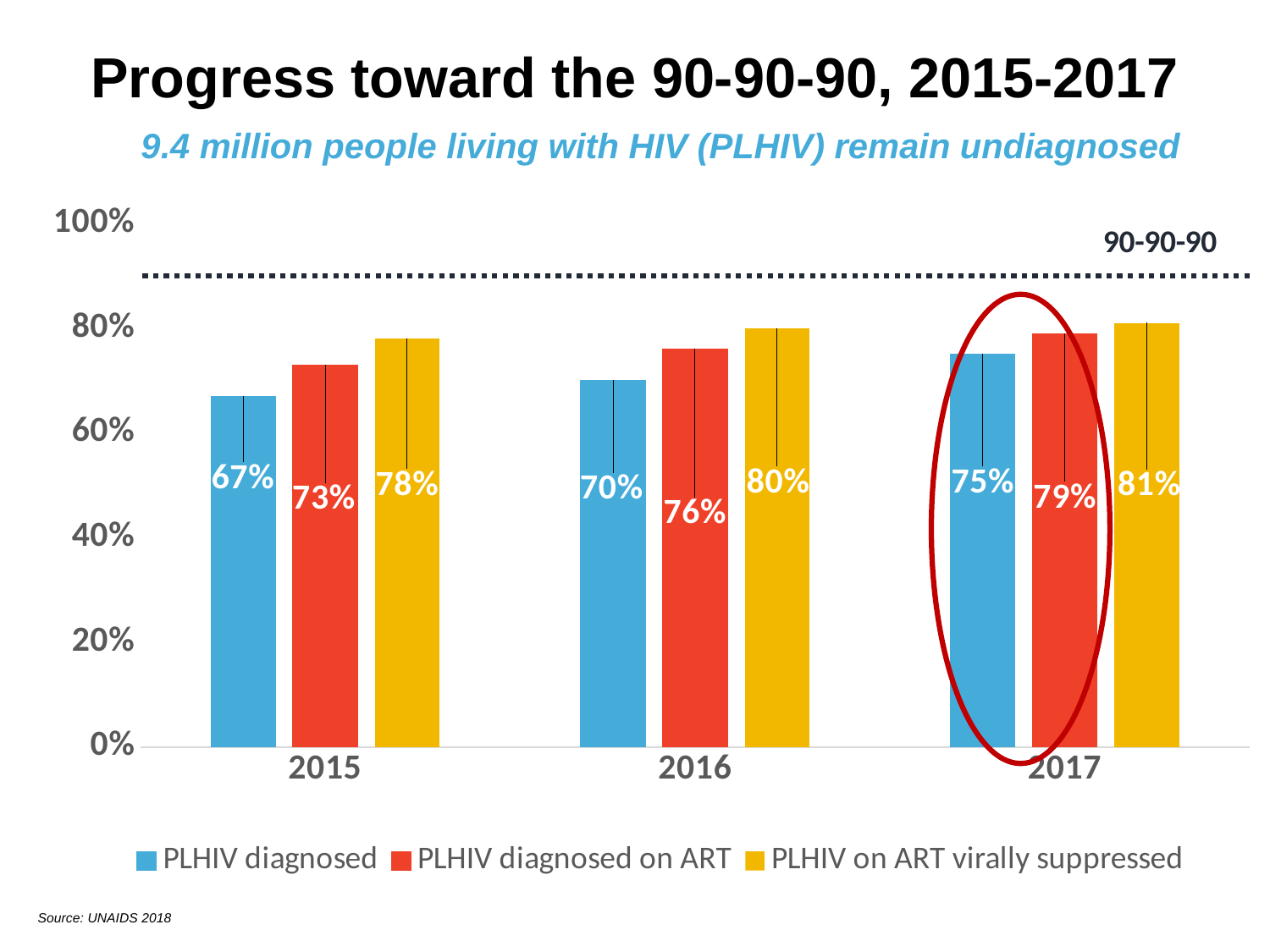
How many series does the legend list? 3 What is the value for PLHIV on ART virally suppressed in 2017? 81% Which is larger: PLHIV on ART virally suppressed in 2016 or PLHIV diagnosed on ART in 2017? PLHIV on ART virally suppressed in 2016 What is the value for PLHIV diagnosed in 2015? 67% Does the value for PLHIV on ART virally suppressed rise or fall from 2015 to 2017? rise What kind of chart is shown on the slide? bar chart What is the difference between PLHIV diagnosed in 2017 and PLHIV diagnosed in 2015? 8% How many years are shown on the x axis? 3 What is the value for PLHIV diagnosed on ART in 2016? 76% Is the value for PLHIV diagnosed in 2016 greater or less than 80%? less In which year is the value for PLHIV diagnosed highest? 2017 In which year is the value for PLHIV diagnosed on ART lowest? 2015